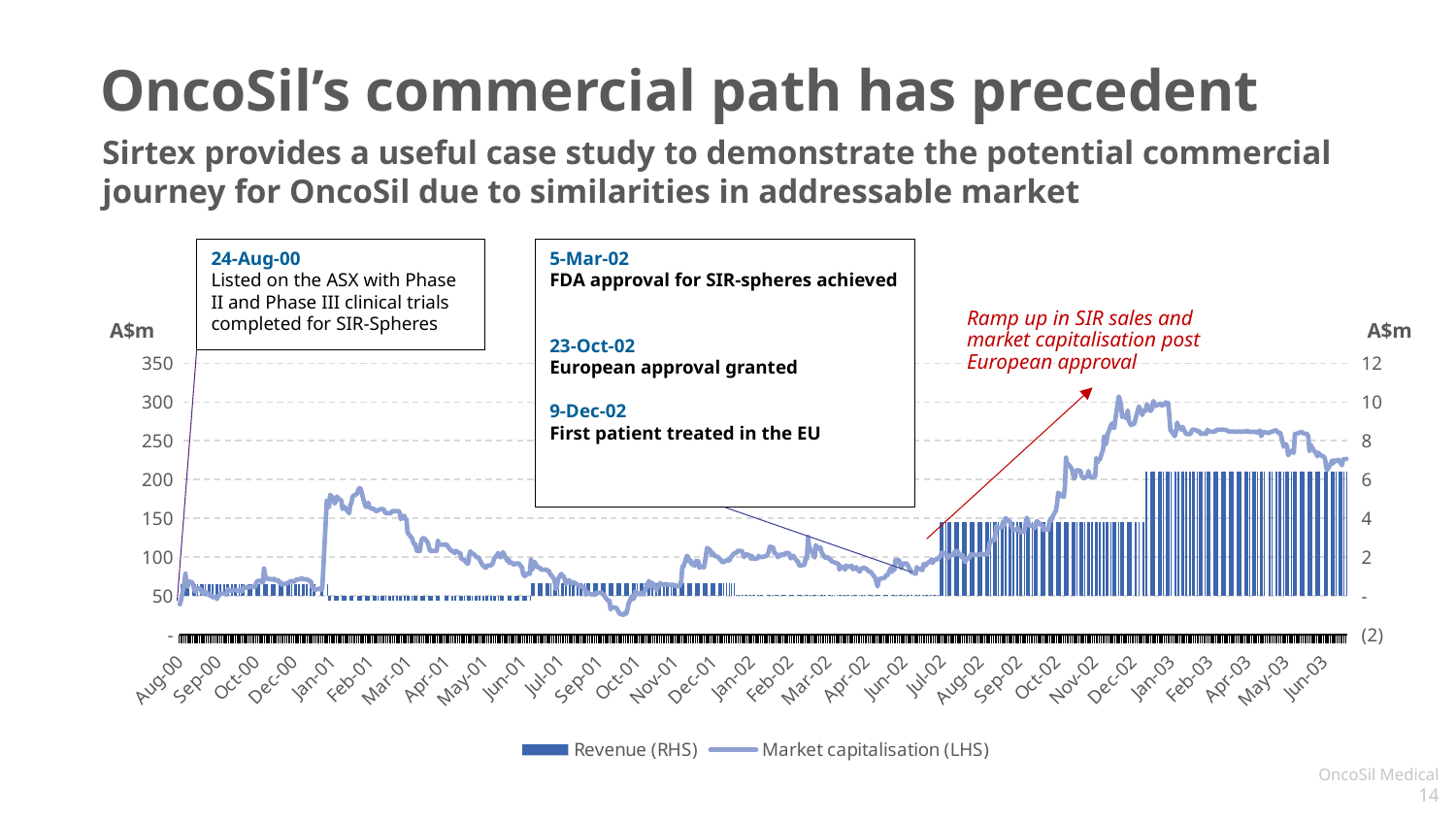
What kind of chart is shown on the slide? A combined bar and line chart Does the market capitalisation line rise or fall between Jul-02 and Dec-02? rise Which is larger, the market capitalisation around Jan-01 or around Jan-02? Jan-01 Which series is plotted as bars on the chart? Revenue (RHS) Is the market capitalisation value around Oct-01 greater or less than 100? less What unit label is shown on both vertical axes of the chart? A$m How many series does the chart legend list? 2 Is the market capitalisation value around Jan-03 greater or less than 250? greater Is the revenue value around Feb-03 greater or less than 4 on the right-hand axis? greater Do the revenue bars generally rise or fall from Aug-00 to Jun-03? rise Which is larger, the revenue around Jan-03 or around Jan-01? Jan-03